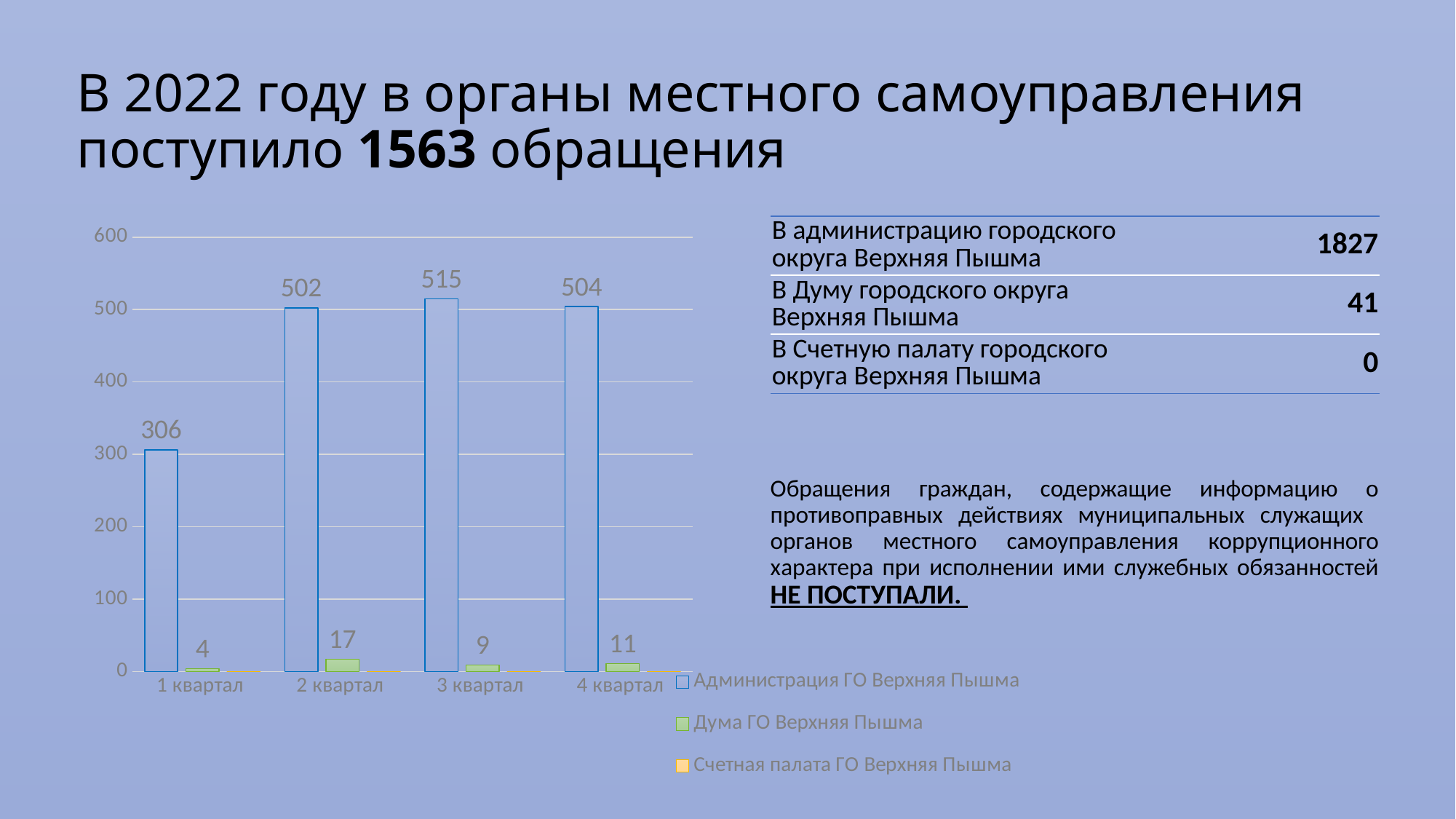
Which series is shown in green in the chart legend? Дума ГО Верхняя Пышма What is the value for Администрация ГО Верхняя Пышма in 3 квартал? 515 What type of chart is shown on the slide? bar chart Which is larger: the Дума ГО Верхняя Пышма value in 3 квартал or in 4 квартал? 4 квартал How many quarters are shown on the x axis of the chart? 4 What is the value for Дума ГО Верхняя Пышма in 2 квартал? 17 In which quarter is the value for Дума ГО Верхняя Пышма the lowest? 1 квартал What is the value for Администрация ГО Верхняя Пышма in 1 квартал? 306 What is the difference between the Администрация ГО Верхняя Пышма values in 2 квартал and 1 квартал? 196 Is the value for Администрация ГО Верхняя Пышма in 4 квартал greater or less than 400? greater How many series does the chart legend list? 3 In which quarter is the value for Администрация ГО Верхняя Пышма the highest? 3 квартал